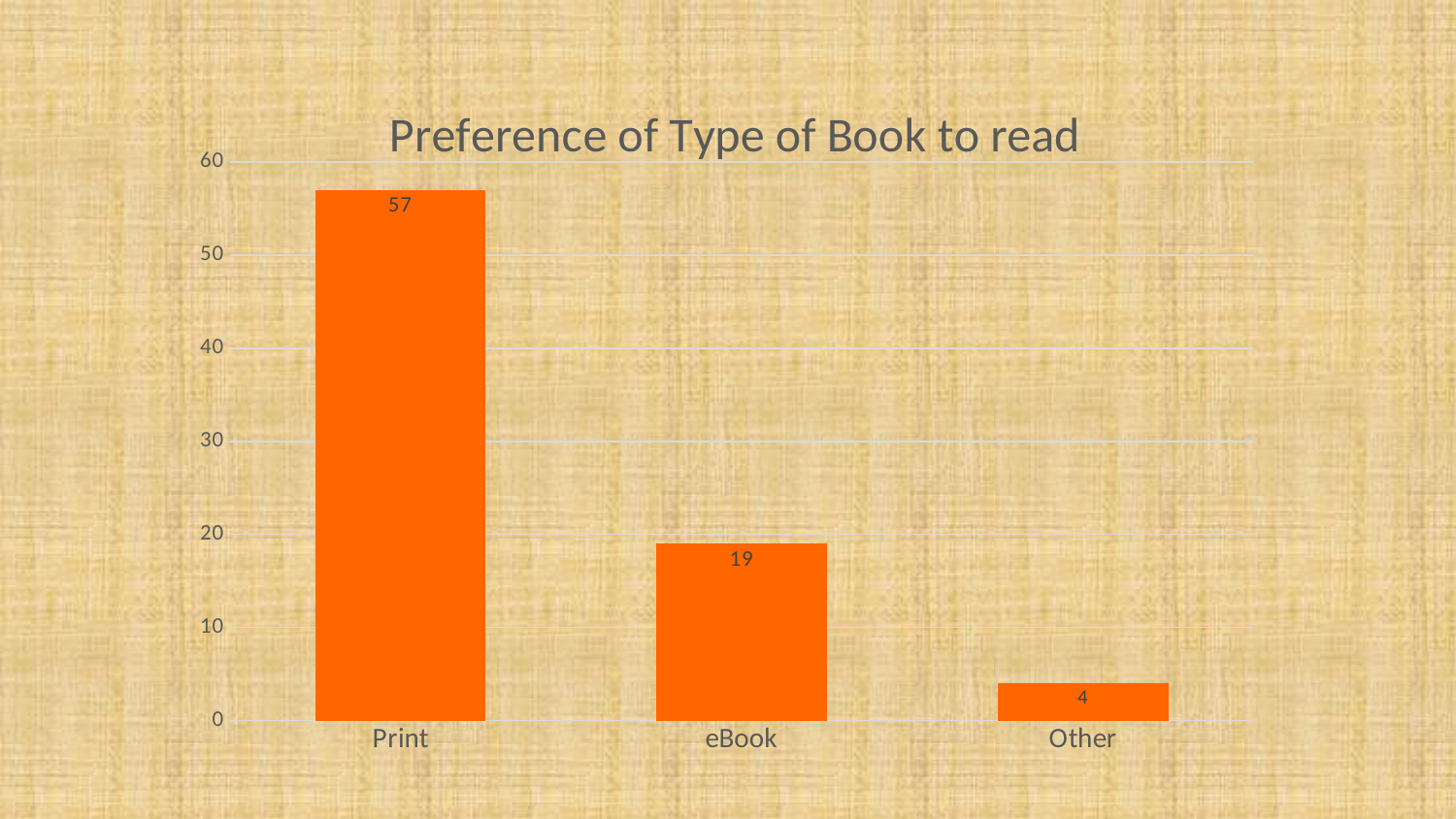
What is the title of the chart? Preference of Type of Book to read Which is larger, the value for eBook or the value for Other? eBook What is the value for Print? 57 Which category has the lowest value? Other What is the value for eBook? 19 What is the difference between the values for Print and eBook? 38 How many categories are shown on the x axis? 3 Which category has the highest value? Print What is the value for Other? 4 Is the value for Print greater or less than 50? greater What kind of chart is shown on the slide? bar chart What is the difference between the values for eBook and Other? 15